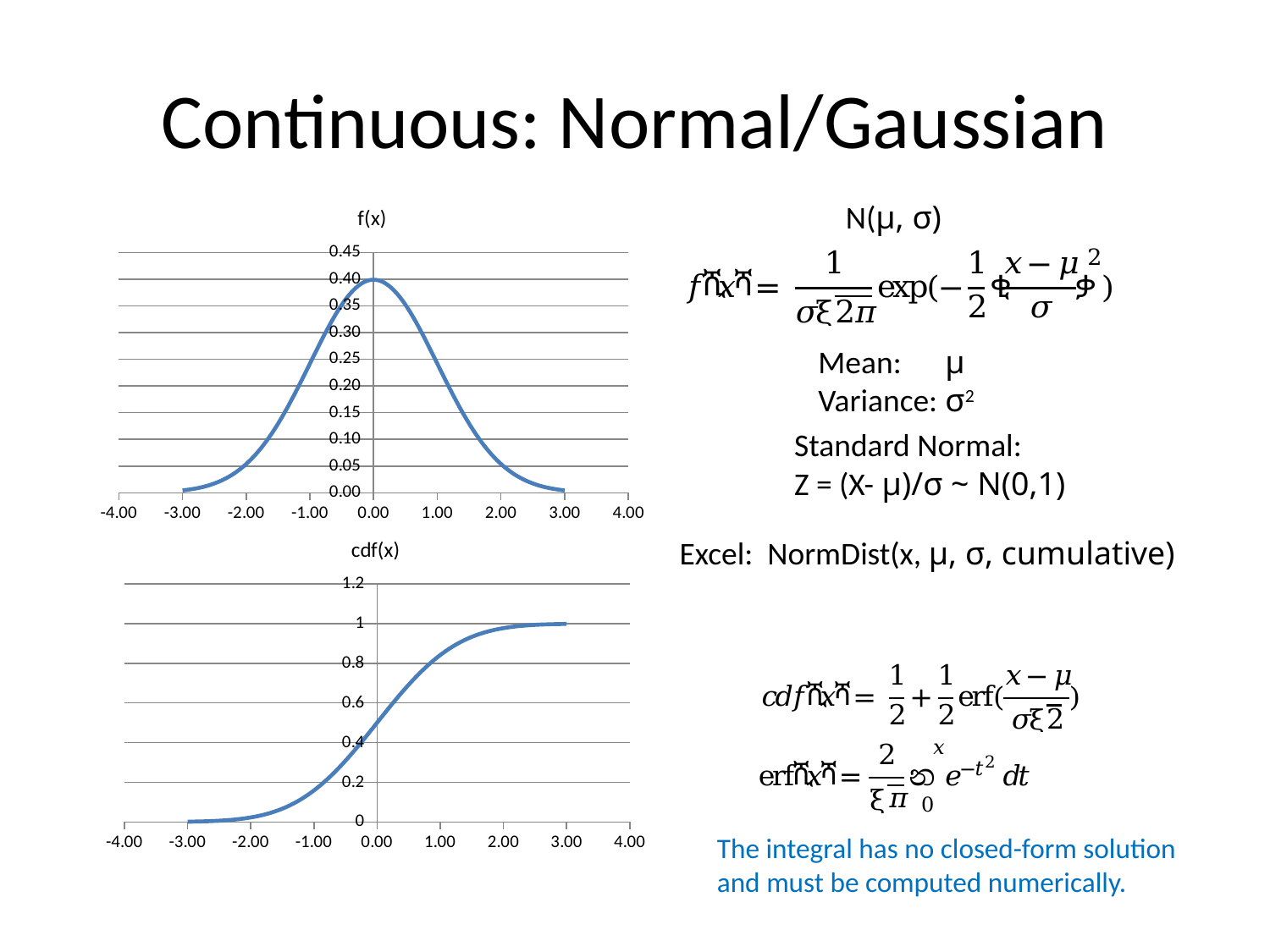
In the f(x) chart, is the value at x = 2.00 greater or less than 0.10? less In the cdf(x) chart, which is larger: the value at x = 1.00 or the value at x = -1.00? the value at x = 1.00 In the f(x) chart, is the value at x = 0.00 greater or less than 0.30? greater What kind of chart is the bottom chart titled cdf(x)? line chart In the f(x) chart, is the value at x = -3.00 greater or less than 0.05? less What kind of chart is the top chart titled f(x)? line chart What is the title of the top chart on the slide? f(x) In the f(x) chart, at which x value does the curve reach its highest point? 0.00 In the cdf(x) chart, do the values rise or fall as x increases from -3.00 to 3.00? rise What is the title of the bottom chart on the slide? cdf(x)